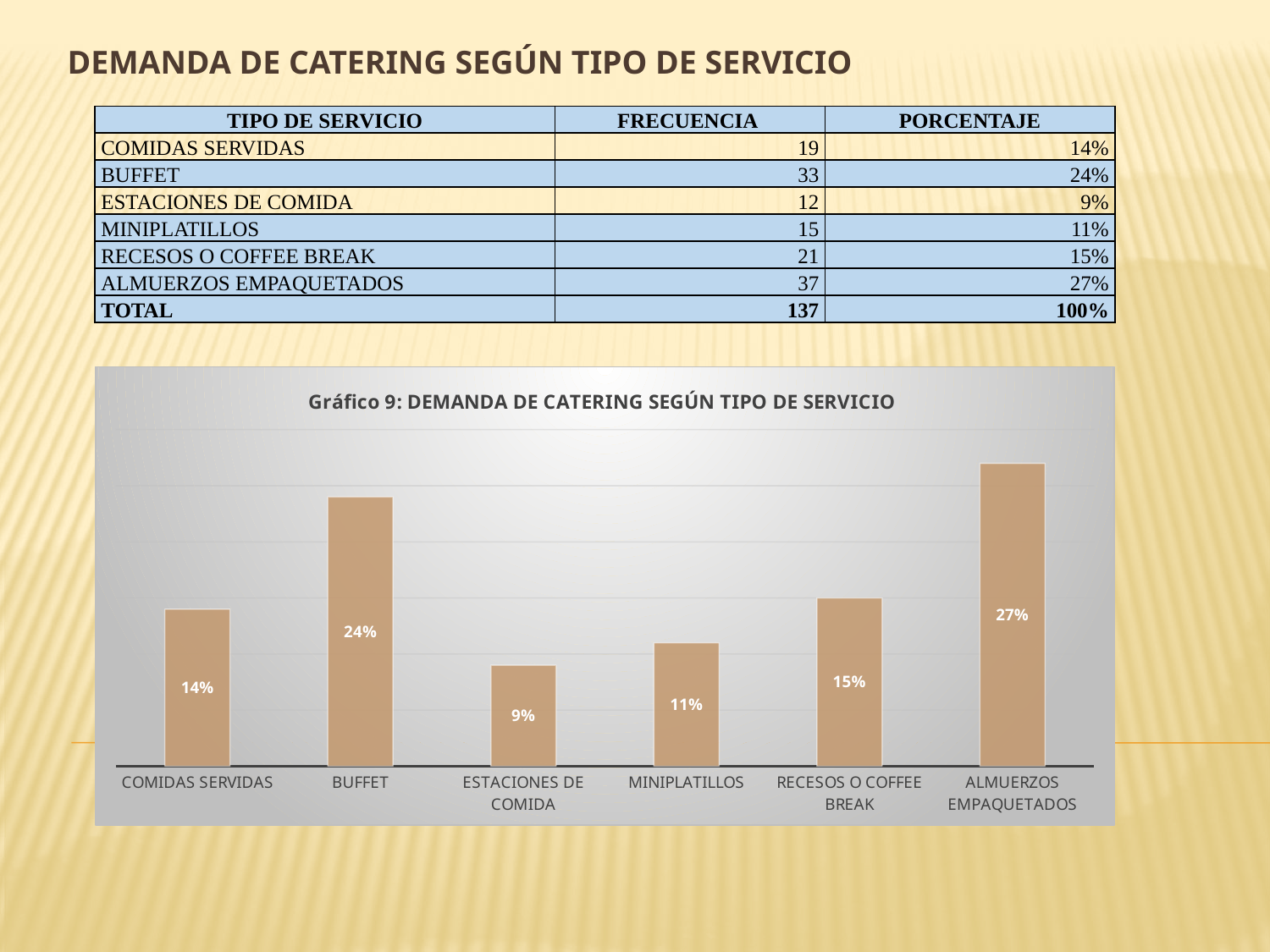
Which category has the lowest value in the chart? ESTACIONES DE COMIDA What kind of chart is shown on the slide? Bar chart What is the value for RECESOS O COFFEE BREAK in the chart? 15% What is the difference between the values for BUFFET and MINIPLATILLOS? 13% Which is larger, the value for COMIDAS SERVIDAS or the value for RECESOS O COFFEE BREAK? RECESOS O COFFEE BREAK What is the difference between the values for ALMUERZOS EMPAQUETADOS and COMIDAS SERVIDAS? 13% Which category has the highest value in the chart? ALMUERZOS EMPAQUETADOS What is the value for ESTACIONES DE COMIDA in the chart? 9% What is the value for BUFFET in the chart? 24% What is the title of the chart? Gráfico 9: DEMANDA DE CATERING SEGÚN TIPO DE SERVICIO What is the value for ALMUERZOS EMPAQUETADOS in the chart? 27% How many categories are shown in the chart? 6